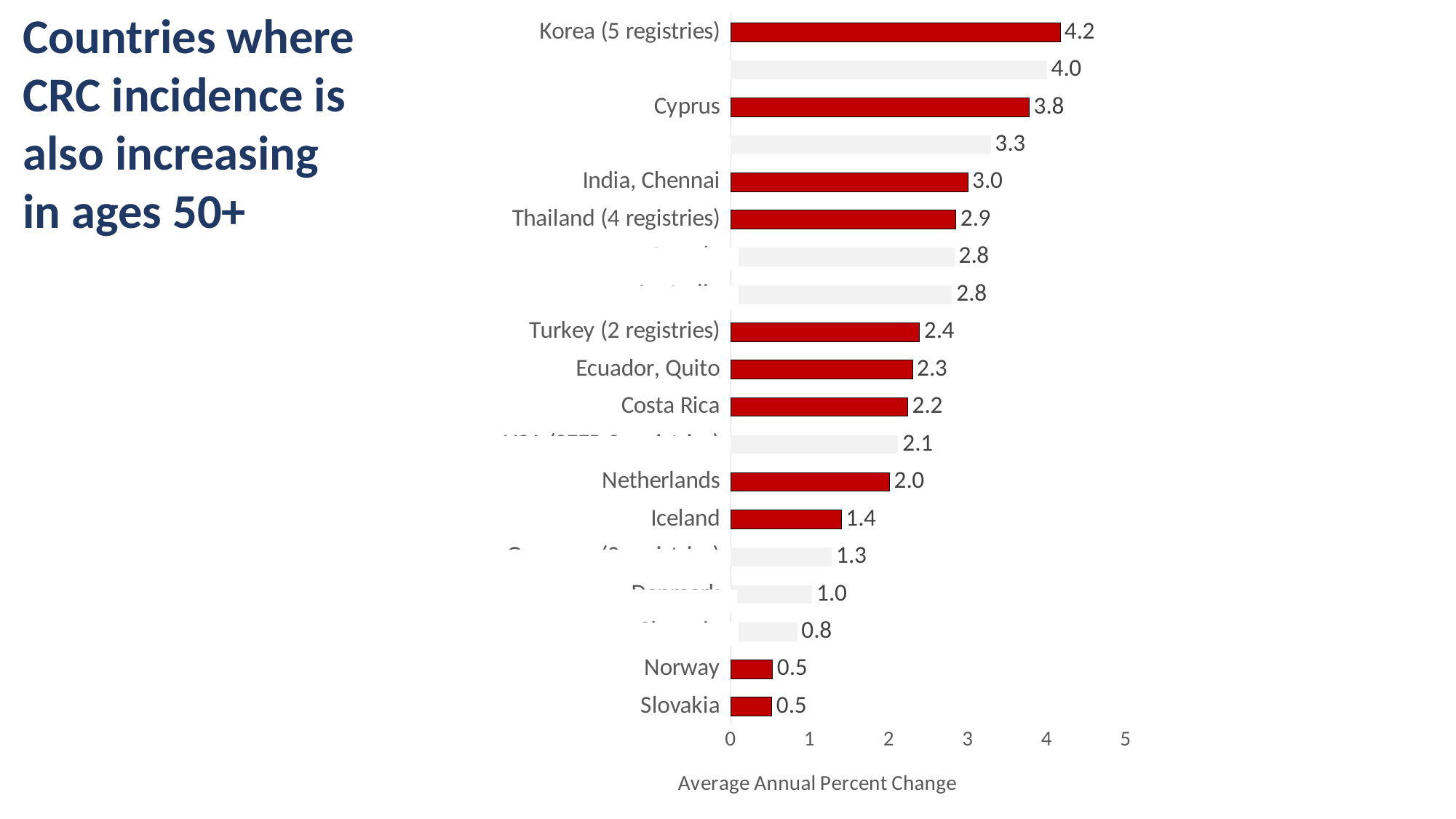
What is the title of the horizontal axis? Average Annual Percent Change What is the average annual percent change for Korea (5 registries)? 4.2 What is the value for Thailand (4 registries)? 2.9 What kind of chart is shown on the slide? Bar chart Which has a larger value, Cyprus or India, Chennai? Cyprus Which country has the highest average annual percent change? Korea (5 registries) What value is shown for Cyprus? 3.8 What is the difference between the values for Netherlands and Norway? 1.5 Is the value for Turkey (2 registries) greater or less than 2? greater How many bars are plotted in the chart? 19 What value is shown for Iceland? 1.4 What is the difference between the values for Korea (5 registries) and Cyprus? 0.4